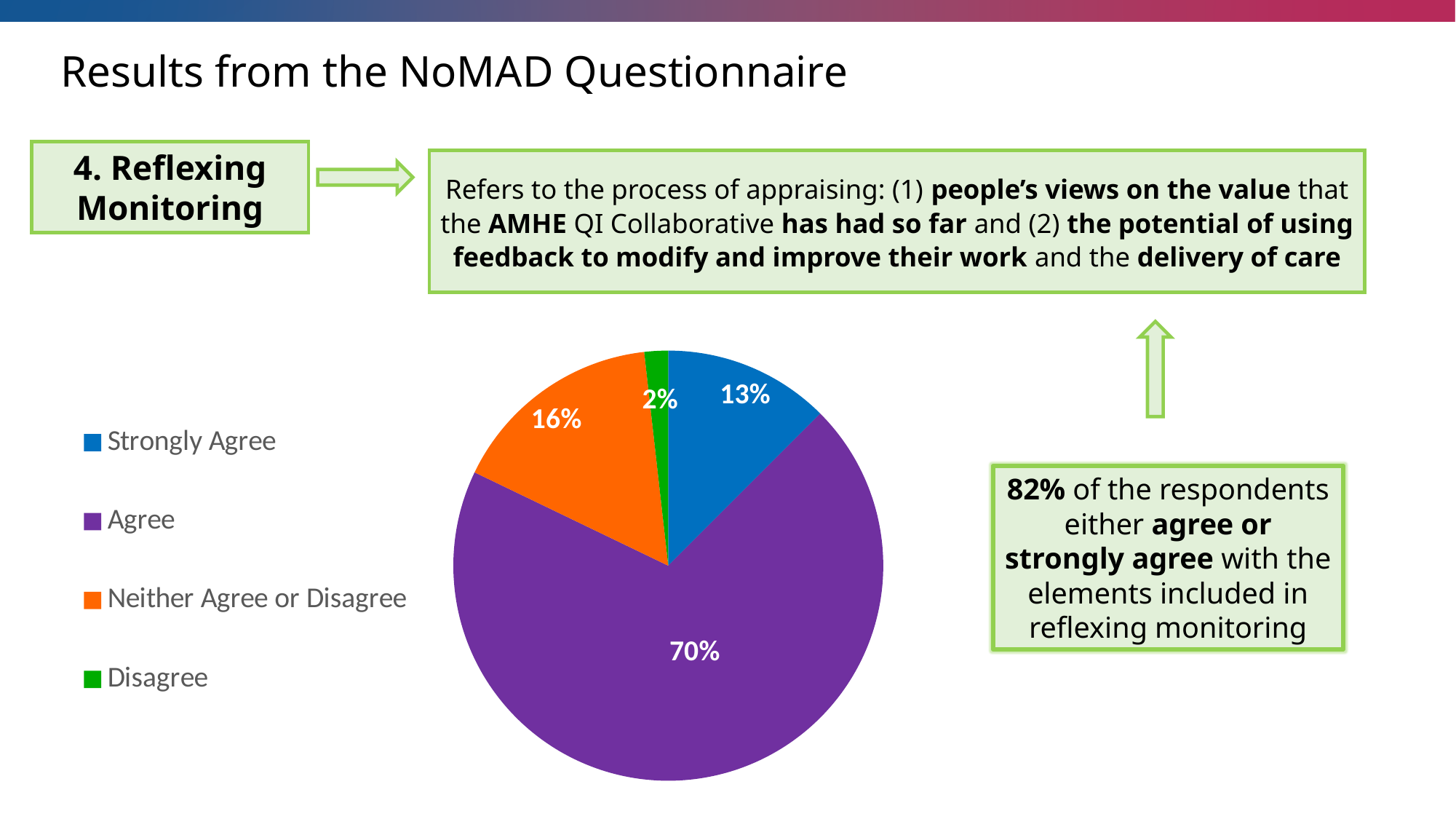
What kind of chart is shown on the slide? pie chart How many categories does the pie chart show? 4 What percentage of respondents answered Strongly Agree? 13% What is the difference in percentage points between Agree and Strongly Agree? 57 Which is larger, the share for Neither Agree or Disagree or the share for Strongly Agree? Neither Agree or Disagree Which response category has the smallest share of the pie? Disagree What colour represents the Agree slice in the pie chart? purple Which response category has the largest share of the pie? Agree What is the combined share of Agree and Strongly Agree? 82% What percentage of respondents answered Agree? 70% What percentage of respondents answered Neither Agree or Disagree? 16% What percentage of respondents answered Disagree? 2%